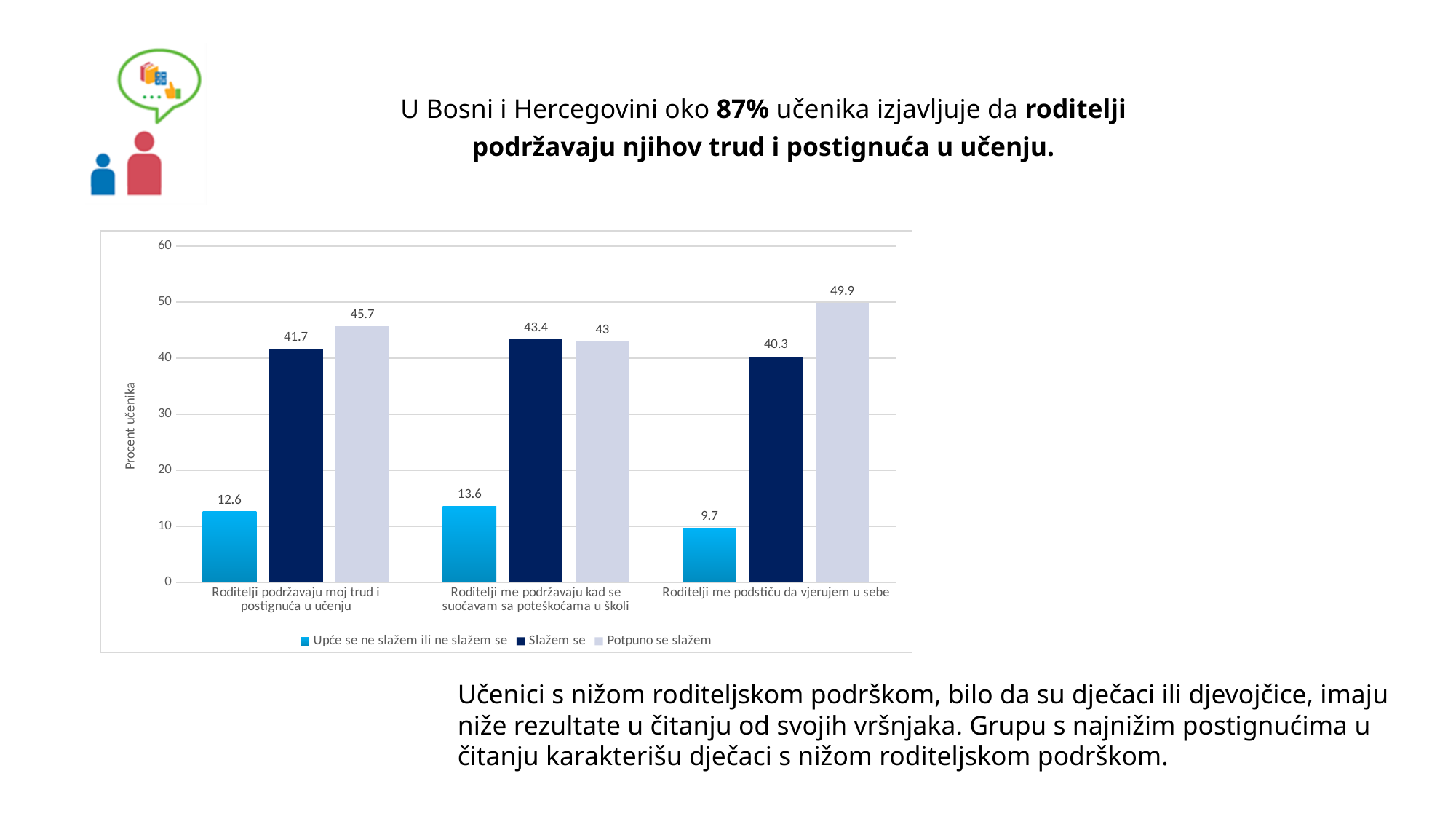
Is the value for "Slažem se" in the category "Roditelji me podstiču da vjerujem u sebe" greater or less than 50? less What is the value for "Potpuno se slažem" in the category "Roditelji me podstiču da vjerujem u sebe"? 49.9 What is the difference between "Potpuno se slažem" and "Slažem se" in the category "Roditelji me podstiču da vjerujem u sebe"? 9.6 What is the value for "Slažem se" in the category "Roditelji podržavaju moj trud i postignuća u učenju"? 41.7 Which category has the highest value for "Potpuno se slažem"? Roditelji me podstiču da vjerujem u sebe What is the value for "Upće se ne slažem ili ne slažem se" in the category "Roditelji me podržavaju kad se suočavam sa poteškoćama u školi"? 13.6 How many series does the chart legend list? 3 What kind of chart is shown on the slide? bar chart How many categories are shown on the x axis of the chart? 3 Which category has the lowest value for "Upće se ne slažem ili ne slažem se"? Roditelji me podstiču da vjerujem u sebe In the category "Roditelji me podržavaju kad se suočavam sa poteškoćama u školi", which is larger: "Slažem se" or "Potpuno se slažem"? Slažem se What is the label of the vertical axis of the chart? Procent učenika